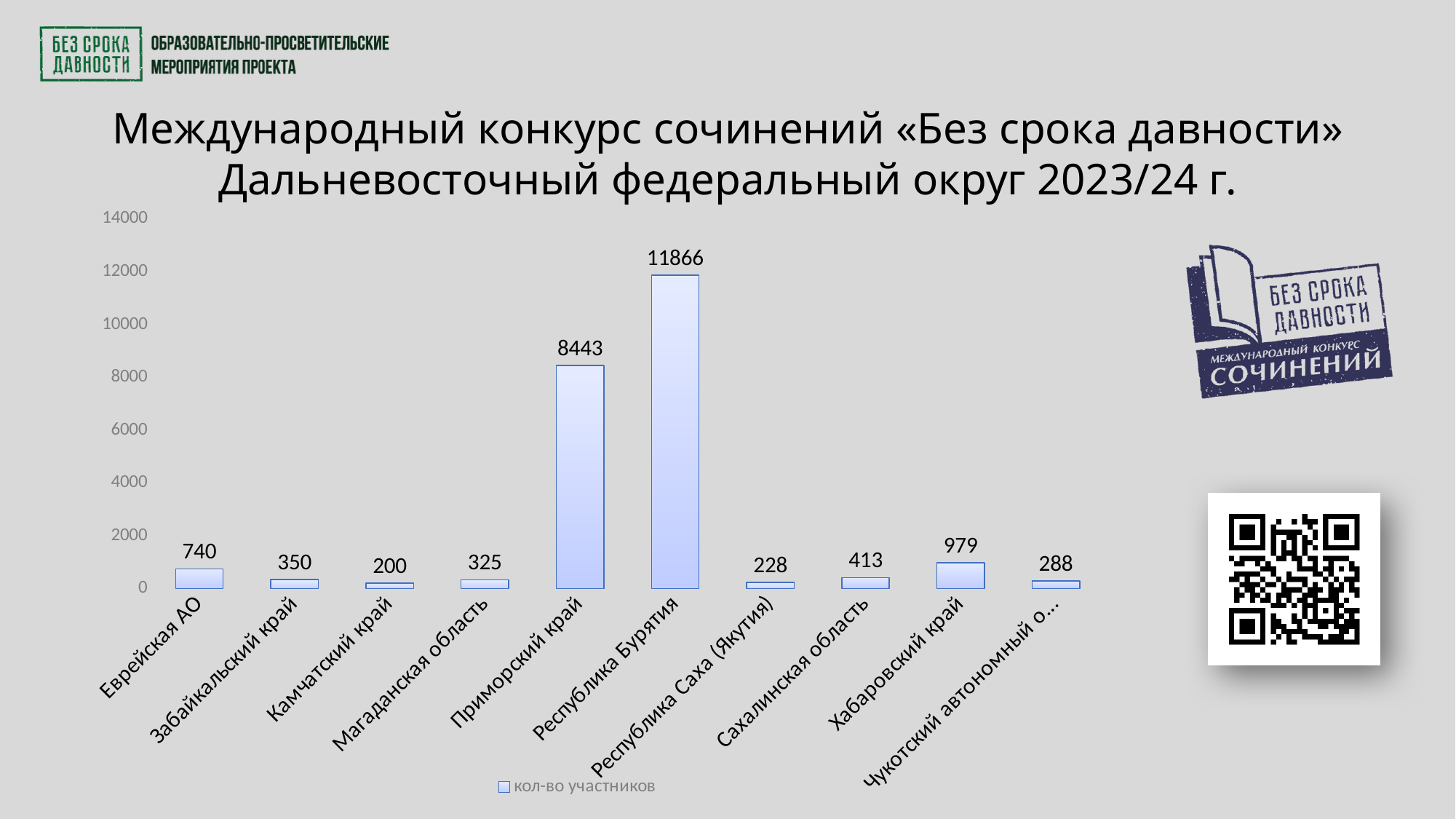
Which category has the lowest value? Камчатский край Which category has the highest value? Республика Бурятия Is the value for Приморский край greater or less than 8000? greater What is the value for Хабаровский край? 979 How many categories are shown on the x axis? 10 Which is larger, the value for Еврейская АО or the value for Забайкальский край? Еврейская АО How many series does the legend list? 1 What is the difference between the values for Республика Бурятия and Приморский край? 3423 What is the value for Республика Саха (Якутия)? 228 What is the value for Приморский край? 8443 What kind of chart is shown on the slide? bar chart What is the legend entry for the series? кол-во участников